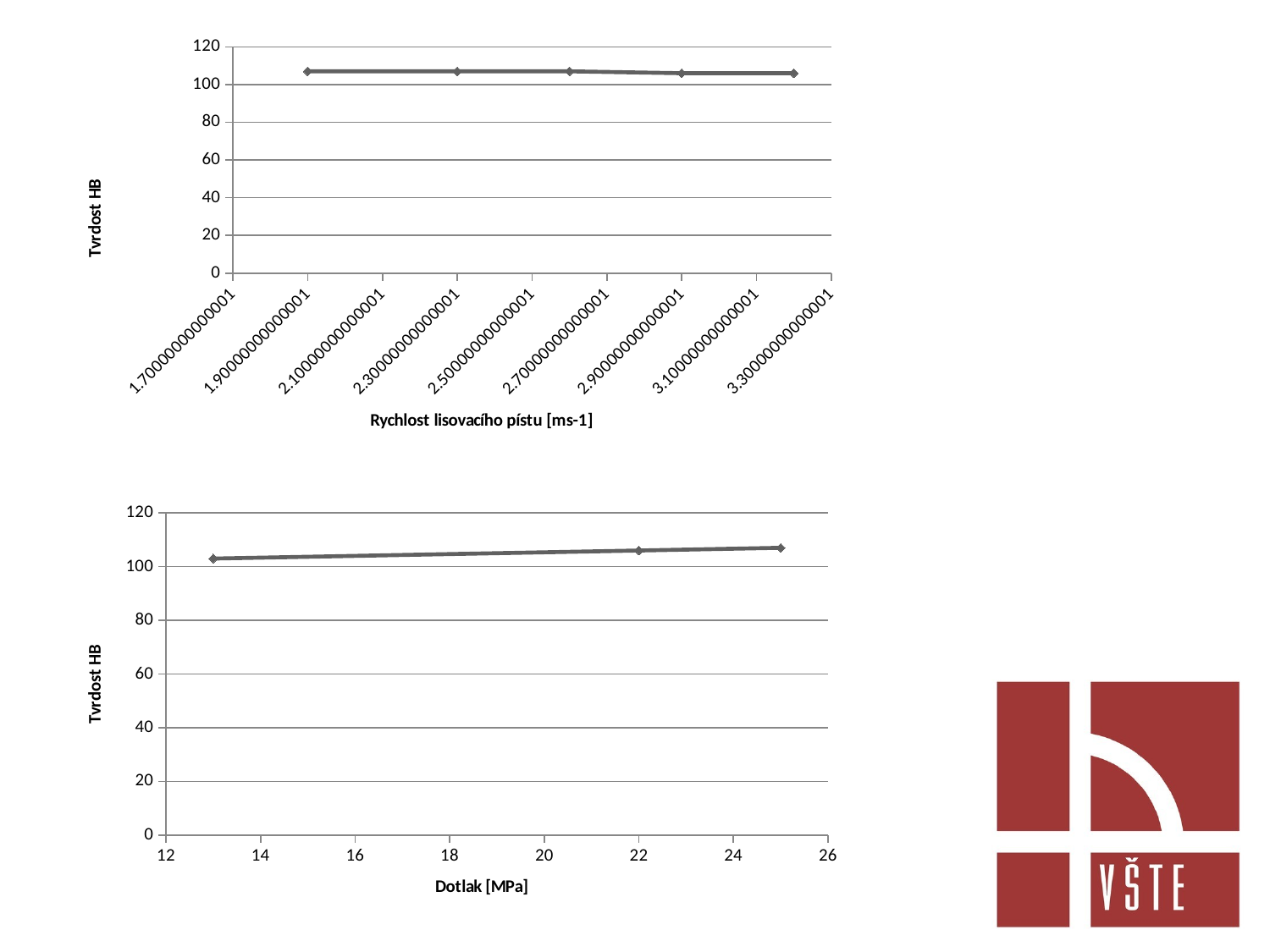
What is the y-axis label of the top chart? Tvrdost HB In the top chart (Rychlost lisovacího pístu), is the value at the last plotted point greater or less than 120? less How many data points are plotted in the top chart (Rychlost lisovacího pístu)? 5 In the top chart (Rychlost lisovacího pístu), is the value at the first plotted point greater or less than 100? greater In the bottom chart (Dotlak [MPa]), is the value at 13 MPa greater or less than 120? less In the bottom chart (Dotlak [MPa]), at which Dotlak value is the hardness lowest? 13 How many data points are plotted in the bottom chart (Dotlak [MPa])? 3 What kind of chart is the bottom chart on the slide? line chart What is the x-axis label of the bottom chart? Dotlak [MPa] What kind of chart is the top chart on the slide? line chart In the bottom chart (Dotlak [MPa]), do the values rise or fall as Dotlak increases from 13 to 25 MPa? rise